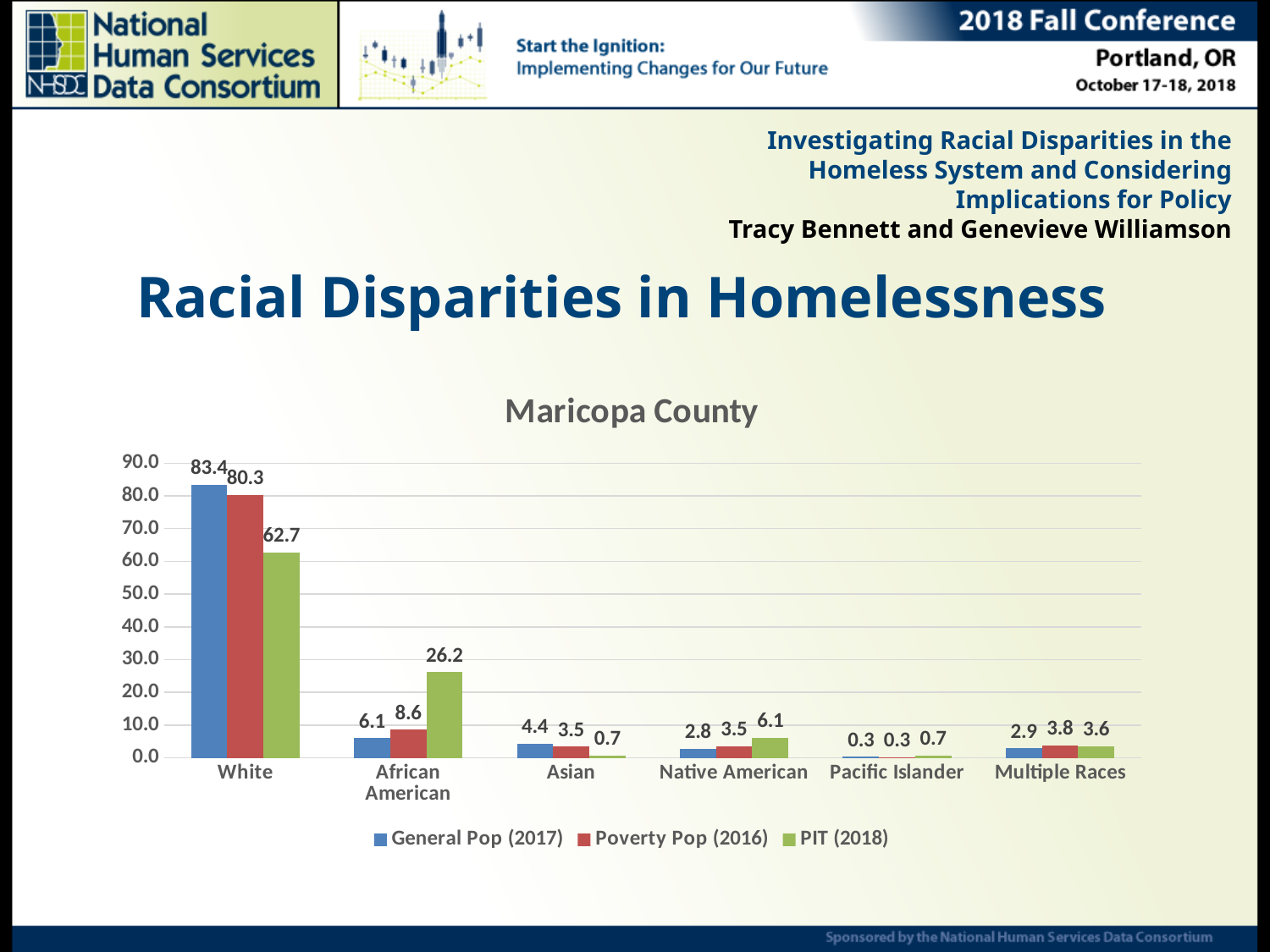
How many categories are shown on the x axis? 6 Which is larger for Asian: General Pop (2017) or PIT (2018)? General Pop (2017) What is the title of the chart? Maricopa County What is the difference between the General Pop (2017) and PIT (2018) values for White? 20.7 What is the PIT (2018) value for African American? 26.2 What is the Poverty Pop (2016) value for Native American? 3.5 Is the PIT (2018) value for White greater or less than 70.0? less What kind of chart is shown? bar chart Which category has the highest PIT (2018) value? White What is the General Pop (2017) value for White? 83.4 Which category has the lowest General Pop (2017) value? Pacific Islander How many series does the legend list? 3